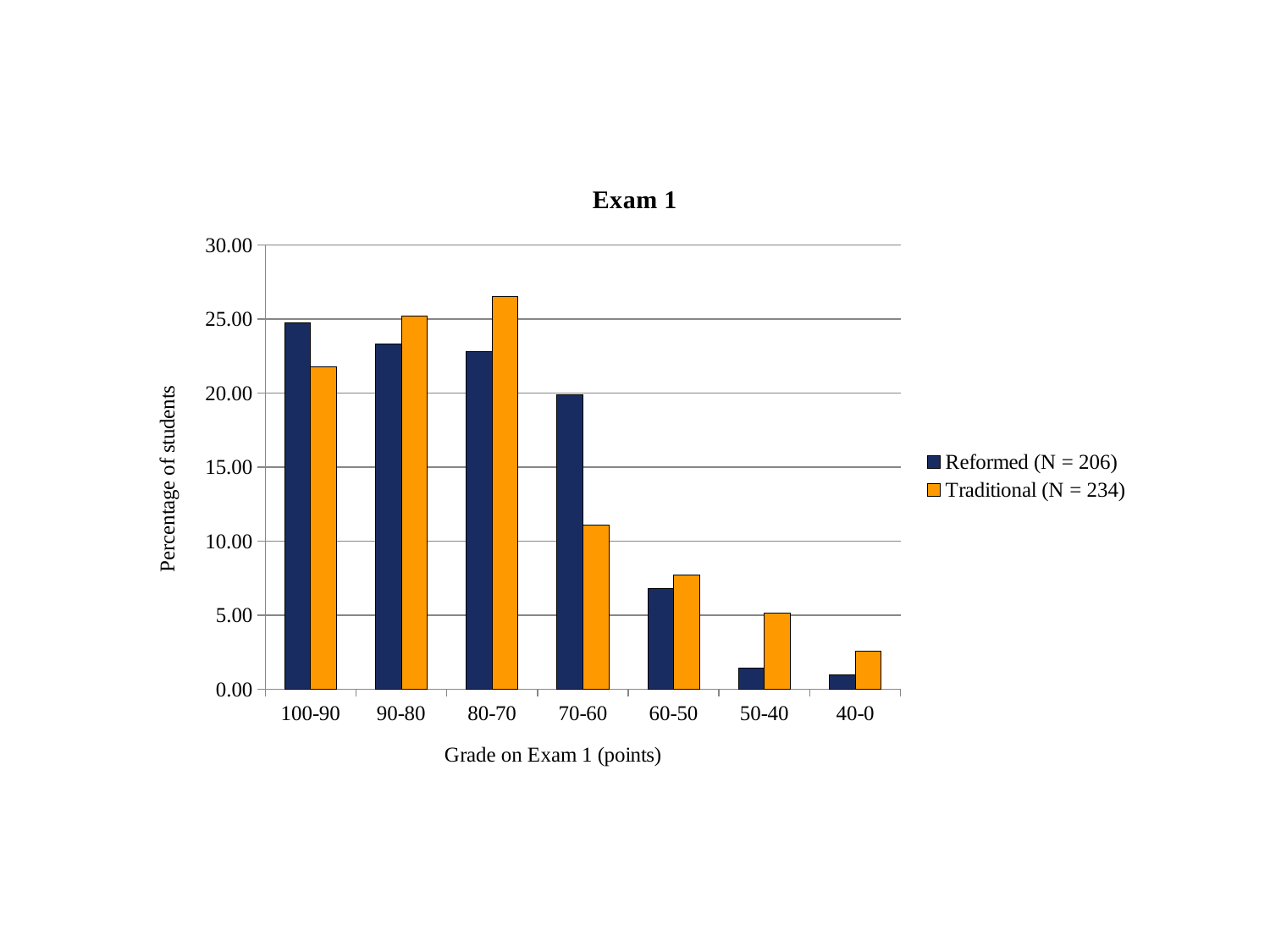
How many series does the legend list? 2 What is the title of the chart? Exam 1 For the 70-60 category, which series has the larger value, Reformed or Traditional? Reformed Is the value for Traditional in the 70-60 category greater or less than 15.00? less What kind of chart is shown on the slide? bar chart Which grade category has the highest value for the Traditional series? 80-70 How many grade categories are shown on the x axis? 7 For the 50-40 category, which series has the larger value, Reformed or Traditional? Traditional Is the value for Reformed in the 70-60 category greater or less than 15.00? greater Which grade category has the highest value for the Reformed series? 100-90 Do the Reformed values rise or fall as you move from 100-90 to 40-0 along the x axis? fall Which grade category has the lowest value for the Traditional series? 40-0